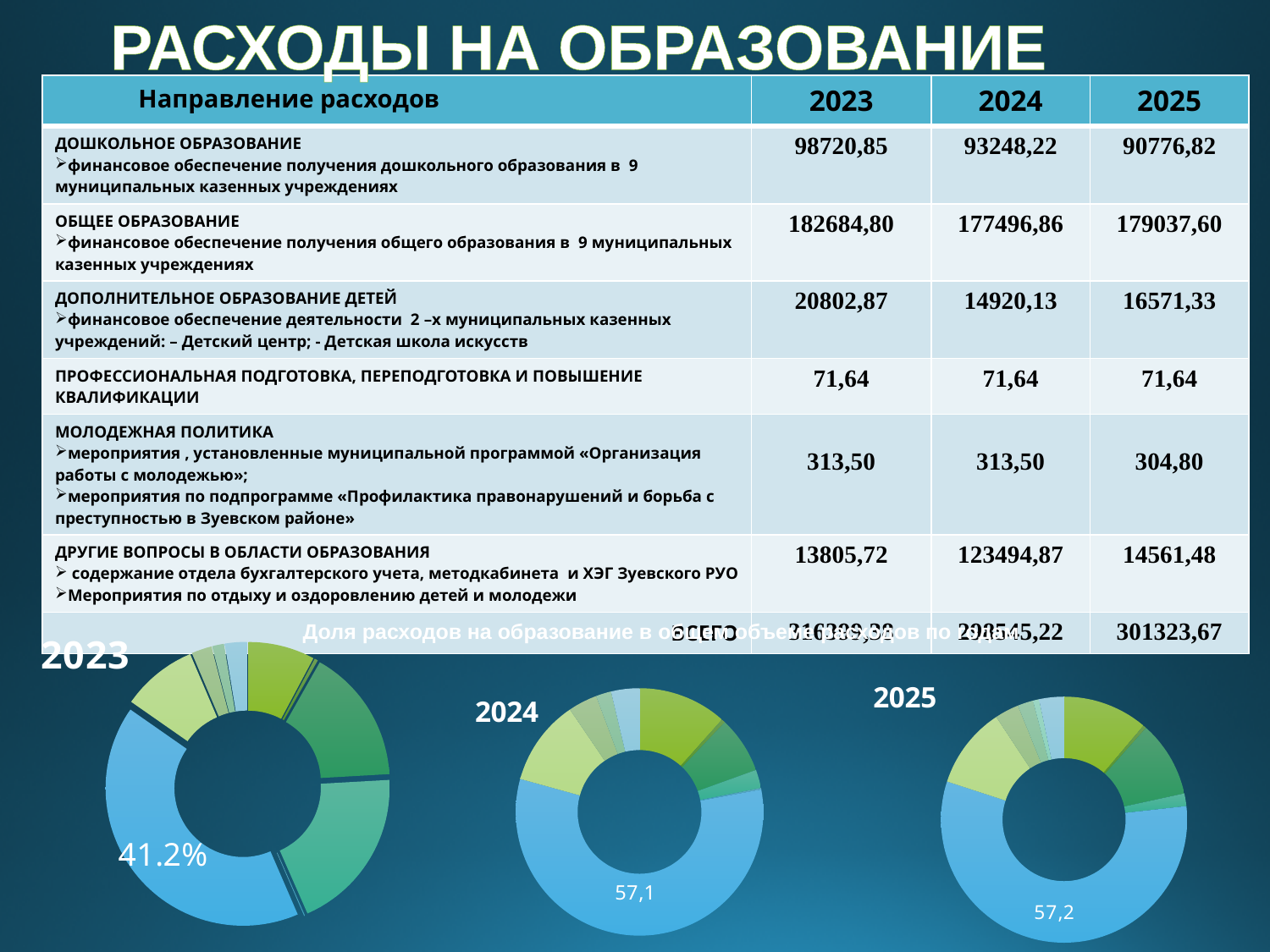
In the 2024 chart, what value is printed on the large blue slice? 57,1 Which years are the three charts labelled with? 2023, 2024, 2025 Which chart has the larger labelled value, the 2024 chart or the 2025 chart? 2025 Which chart has the larger labelled value, the 2023 chart or the 2024 chart? 2024 What is the difference between the labelled values in the 2025 chart and the 2024 chart? 0,1 In the 2024 chart, what colour is the largest slice? blue In the 2023 chart, what value is printed on the large blue slice? 41.2% In the 2025 chart, what value is printed on the large blue slice? 57,2 How many charts are shown on the slide? 3 What kind of chart is used for the 2023, 2024 and 2025 charts at the bottom of the slide? pie chart (doughnut)